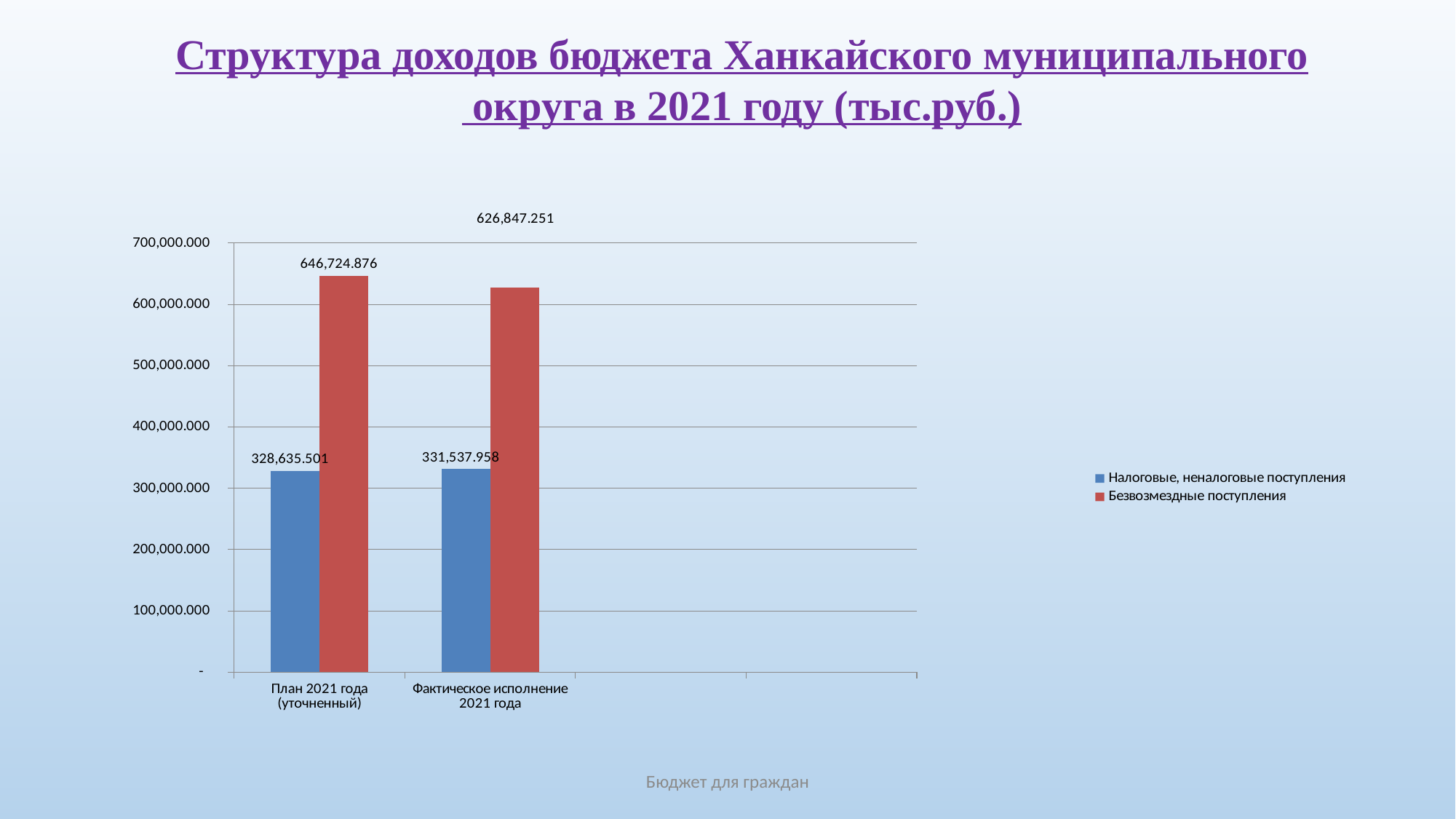
What is the value of Налоговые, неналоговые поступления for План 2021 года (уточненный)? 328,635.501 What is the value of Безвозмездные поступления for Фактическое исполнение 2021 года? 626,847.251 Is Безвозмездные поступления larger for План 2021 года (уточненный) or for Фактическое исполнение 2021 года? План 2021 года (уточненный) What kind of chart is shown on the slide? bar chart How many series does the legend list? 2 Which bar has the lowest value on the chart? Налоговые, неналоговые поступления, План 2021 года (уточненный) How many categories are shown on the x axis? 2 What is the value of Безвозмездные поступления for План 2021 года (уточненный)? 646,724.876 What is the value of Налоговые, неналоговые поступления for Фактическое исполнение 2021 года? 331,537.958 What is the difference between Безвозмездные поступления for План 2021 года (уточненный) and for Фактическое исполнение 2021 года? 19,877.625 Which bar has the highest value on the chart? Безвозмездные поступления, План 2021 года (уточненный) Is the value of Налоговые, неналоговые поступления for Фактическое исполнение 2021 года greater or less than 400,000.000? less